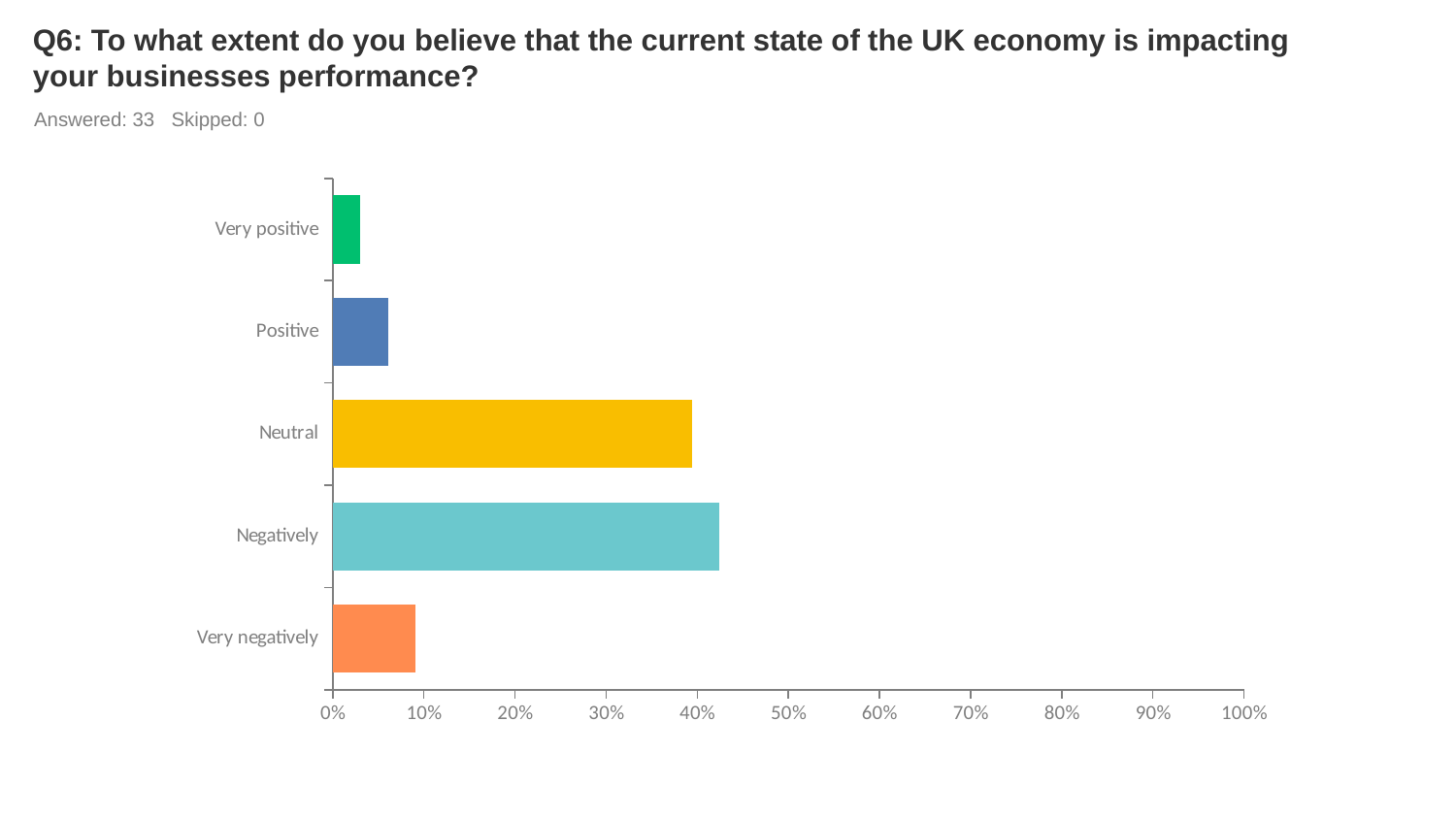
Is the value for Very negatively greater or less than 10%? less Which is larger, the value for Very positive or the value for Positive? Positive Which category has the lowest value? Very positive Is the value for Neutral greater or less than 30%? greater Is the value for Positive greater or less than 10%? less How many respondents answered the question according to the slide? 33 What kind of chart is shown on the slide? bar chart Which is larger, the value for Positive or the value for Very negatively? Very negatively How many categories are plotted on the chart? 5 What is the highest value shown on the x axis? 100%